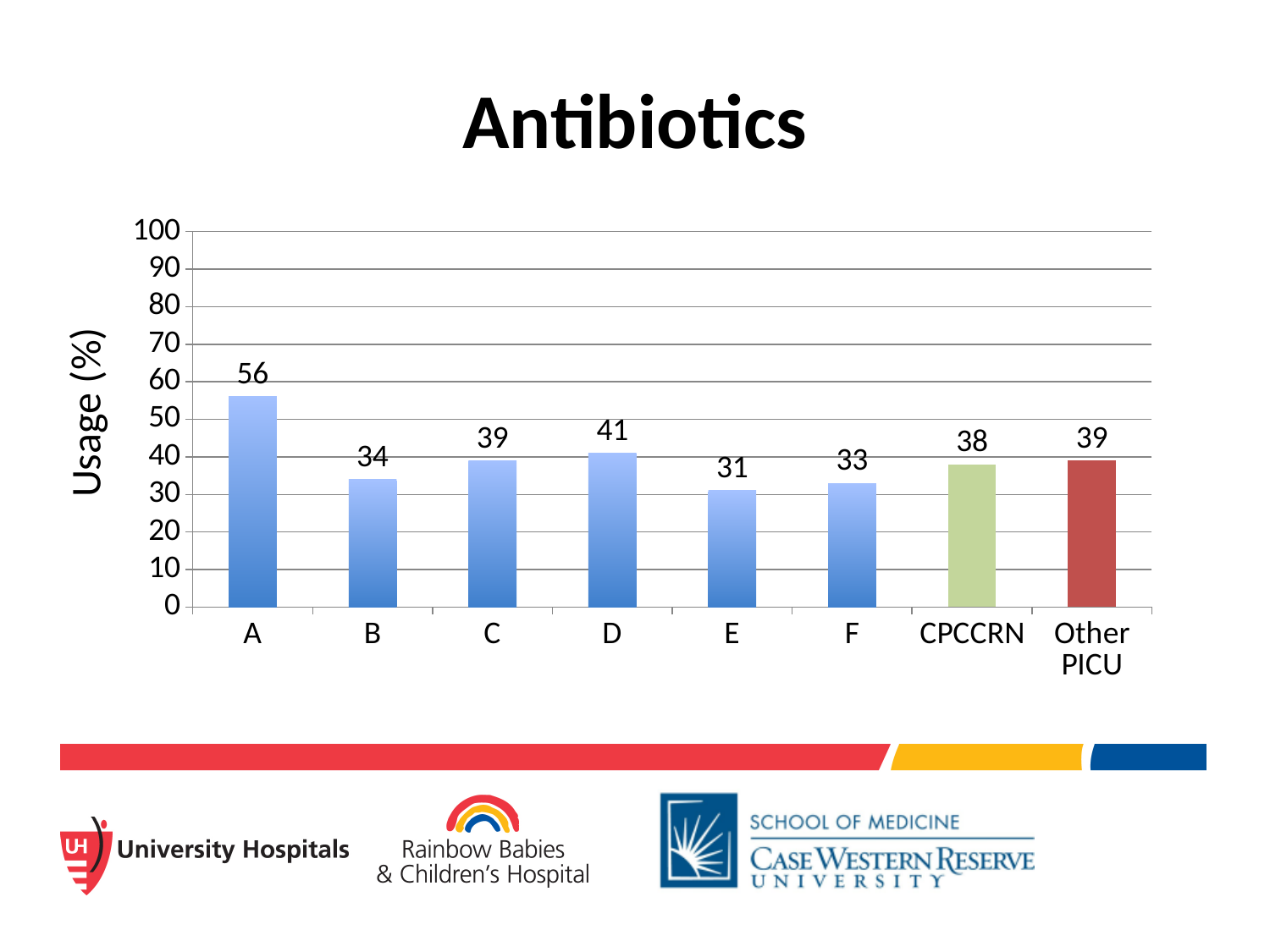
Which category has the highest antibiotic usage? A What is the difference in usage (%) between site D and site E? 10 What is the antibiotic usage (%) for site A? 56 What is the difference in usage (%) between site A and site B? 22 How many categories are shown on the x axis? 8 What type of chart is shown on the slide? Bar chart What is the antibiotic usage (%) for CPCCRN? 38 What is the antibiotic usage (%) for site E? 31 Which has higher antibiotic usage, site D or site F? D What is the antibiotic usage (%) for Other PICU? 39 Which category has the lowest antibiotic usage? E What is the label of the y axis? Usage (%)